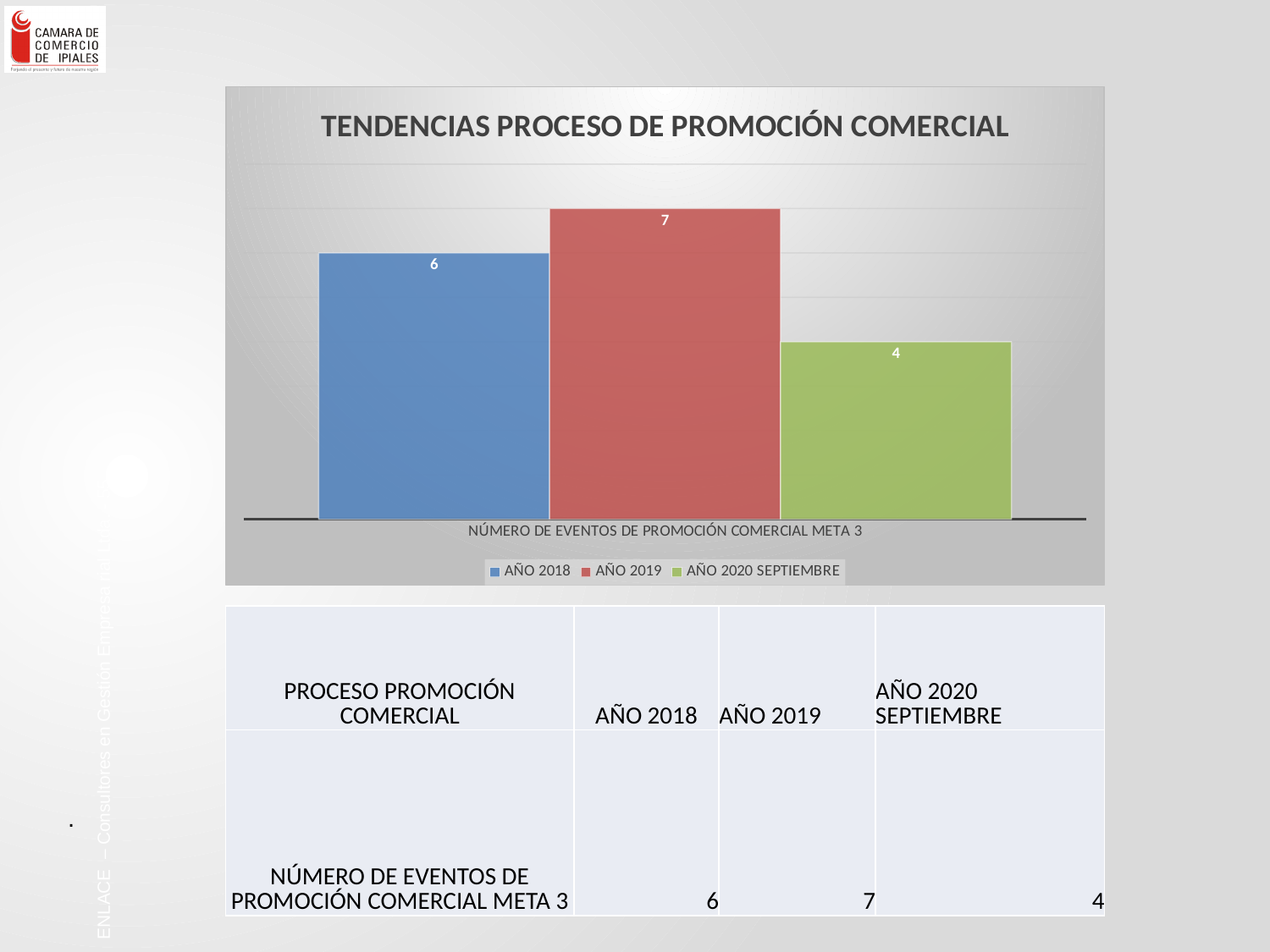
How many series does the legend list? 3 Which is larger, the value for AÑO 2018 or the value for AÑO 2020 SEPTIEMBRE? AÑO 2018 What is the difference between the values for AÑO 2019 and AÑO 2018? 1 What kind of chart is shown on the slide? Bar chart What is the title of the chart? TENDENCIAS PROCESO DE PROMOCIÓN COMERCIAL Which series has the highest value in the chart? AÑO 2019 What is the difference between the values for AÑO 2019 and AÑO 2020 SEPTIEMBRE? 3 What is the value for AÑO 2019 in the chart? 7 What is the value for AÑO 2020 SEPTIEMBRE in the chart? 4 What colour is the bar for AÑO 2019? Red Which series has the lowest value in the chart? AÑO 2020 SEPTIEMBRE What is the value for AÑO 2018 in the chart? 6